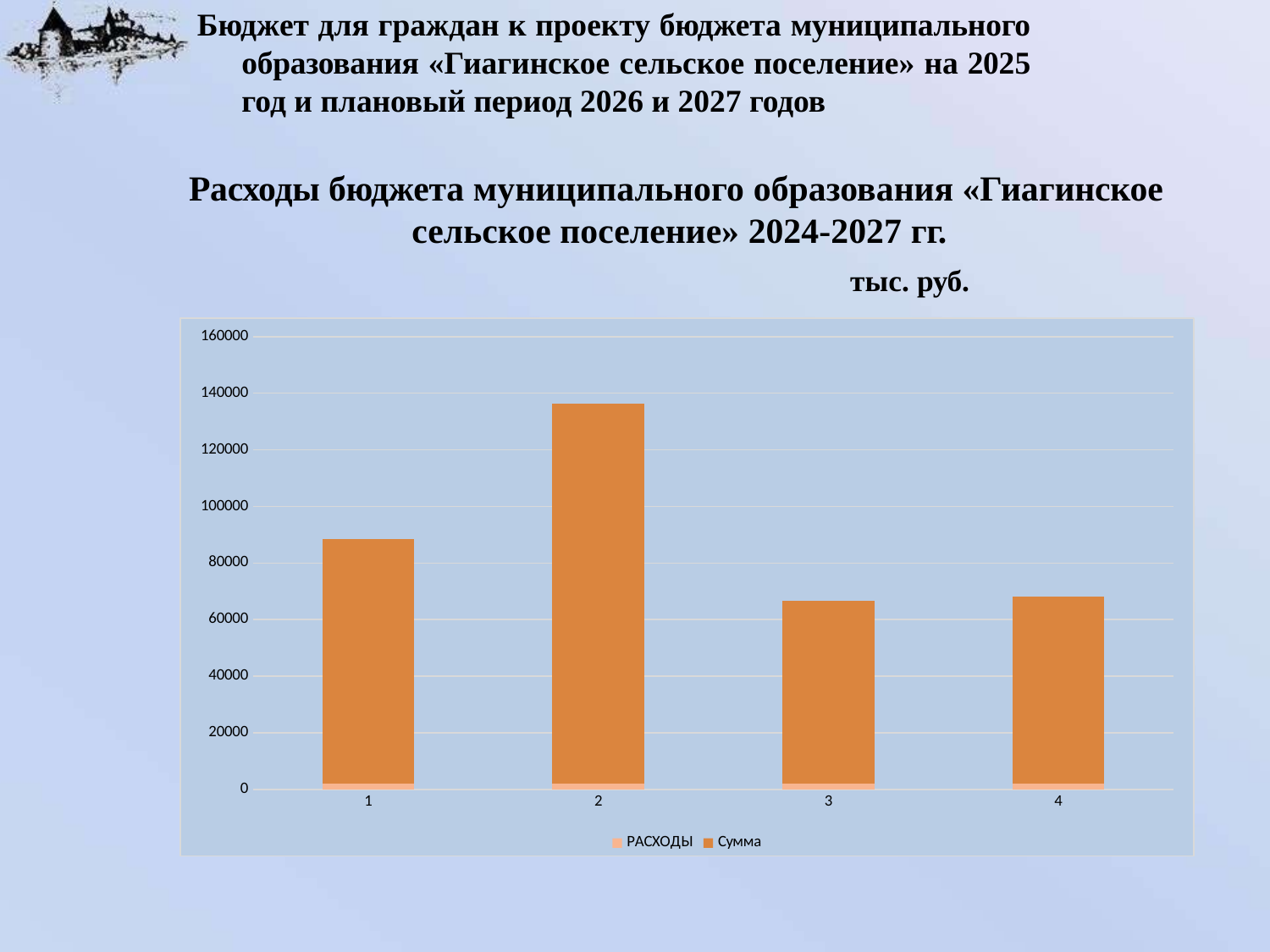
Which category has the highest bar in the chart? 2 Is the value for category 2 greater or less than 140000? less How many categories are shown on the x axis of the chart? 4 How many series does the chart legend list? 2 Is the value for category 1 greater or less than 80000? greater Is the value for category 4 greater or less than 60000? greater Which is larger, the value for category 1 or the value for category 3? category 1 What kind of chart is shown on the slide? bar chart What unit is stated above the chart for the values? тыс. руб.